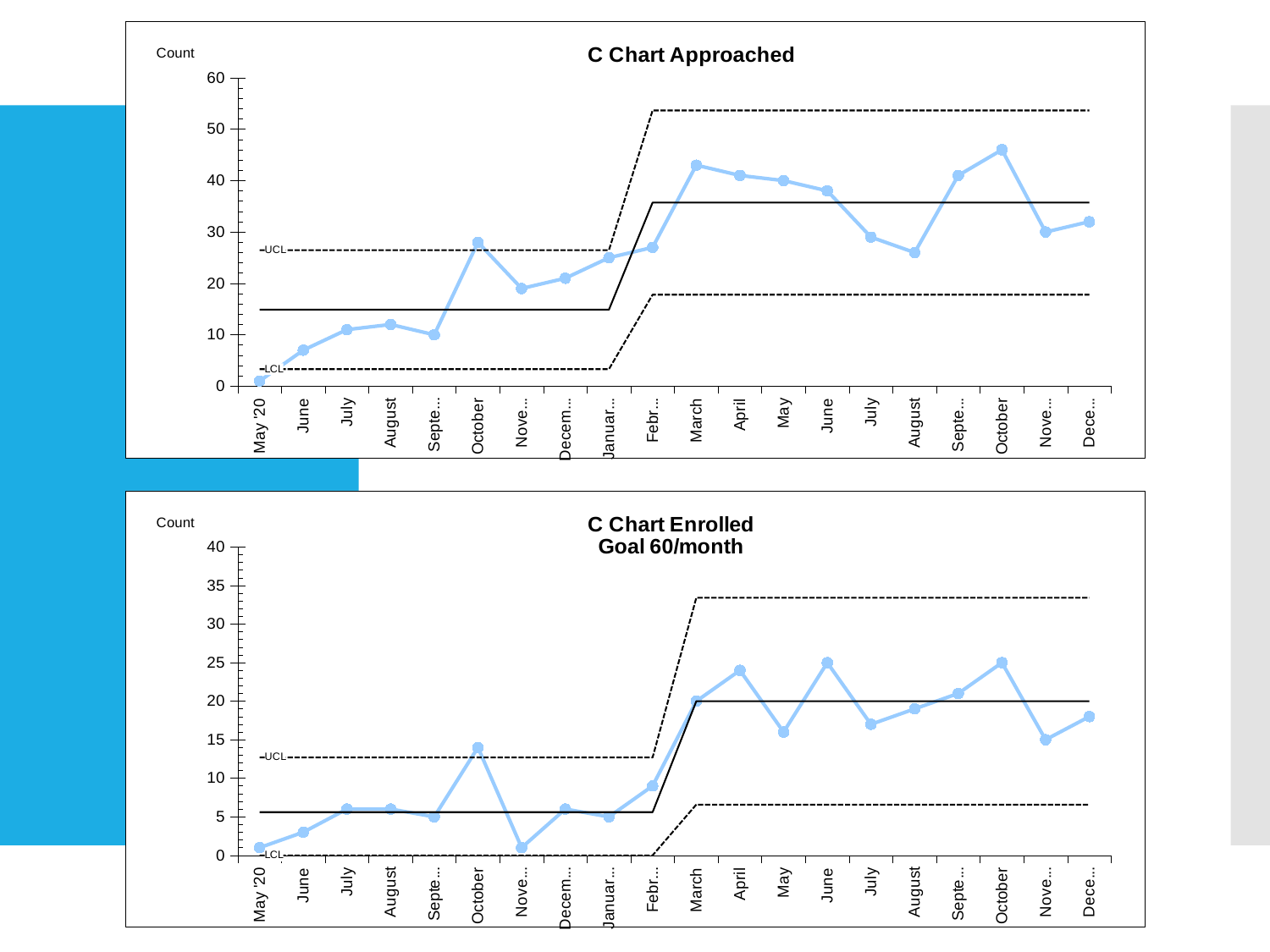
In the 'C Chart Approached' chart, do the plotted values rise or fall from March to the following August? fall In the 'C Chart Approached' chart, is the value for March greater or less than 40? greater In the 'C Chart Enrolled' chart, is the value for the first October on the x axis greater or less than 10? greater How many data points are plotted in the 'C Chart Approached' chart? 20 In the 'C Chart Enrolled' chart, which is larger, the value for April or the value for the second May on the x axis? April In the 'C Chart Approached' chart, is the value for the first October on the x axis greater or less than 20? greater In the 'C Chart Approached' chart, which is larger, the value for March or the value for the second August on the x axis? March What label is shown on the y axis of the 'C Chart Enrolled' chart? Count What kind of chart is the 'C Chart Approached' chart? line chart In the 'C Chart Approached' chart, which month has the highest plotted value? October (the second October on the x axis) In the 'C Chart Approached' chart, which month has the lowest plotted value? May '20 What is the full title of the bottom chart? C Chart Enrolled Goal 60/month